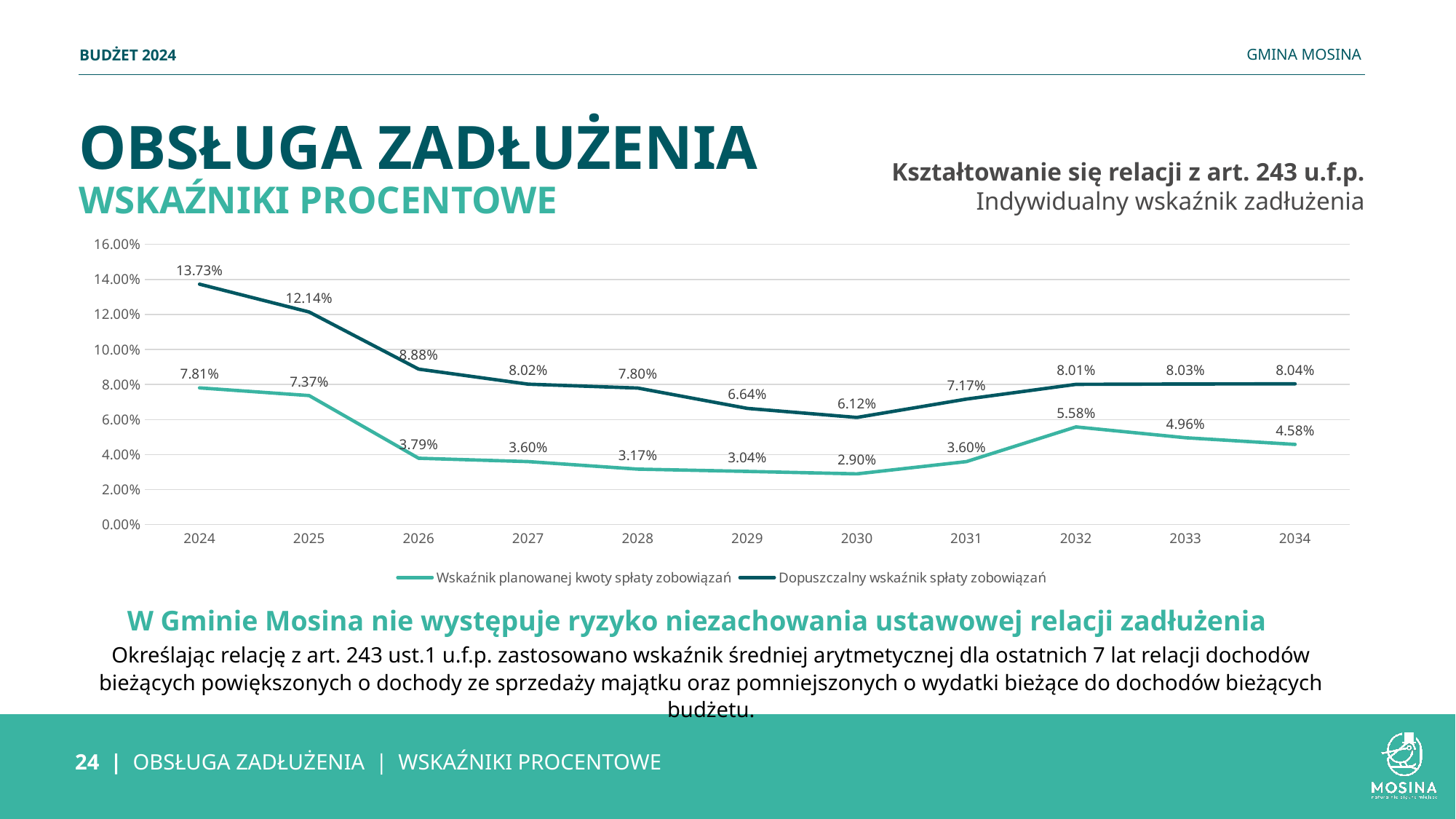
What is the value of 'Wskaźnik planowanej kwoty spłaty zobowiązań' for 2024? 7.81% Is the value of 'Dopuszczalny wskaźnik spłaty zobowiązań' for 2026 greater or less than 8.00%? greater How many series does the legend list? 2 How many years are shown on the x axis? 11 What is the difference between 'Dopuszczalny wskaźnik spłaty zobowiązań' and 'Wskaźnik planowanej kwoty spłaty zobowiązań' in 2024? 5.92% Does 'Dopuszczalny wskaźnik spłaty zobowiązań' rise or fall from 2024 to 2030? fall In which year is 'Wskaźnik planowanej kwoty spłaty zobowiązań' lowest? 2030 In which year is 'Dopuszczalny wskaźnik spłaty zobowiązań' highest? 2024 What is the value of 'Wskaźnik planowanej kwoty spłaty zobowiązań' for 2032? 5.58% What kind of chart is shown on the slide? line chart What is the value of 'Dopuszczalny wskaźnik spłaty zobowiązań' for 2030? 6.12% Which is larger: 'Wskaźnik planowanej kwoty spłaty zobowiązań' in 2025 or in 2033? 2025